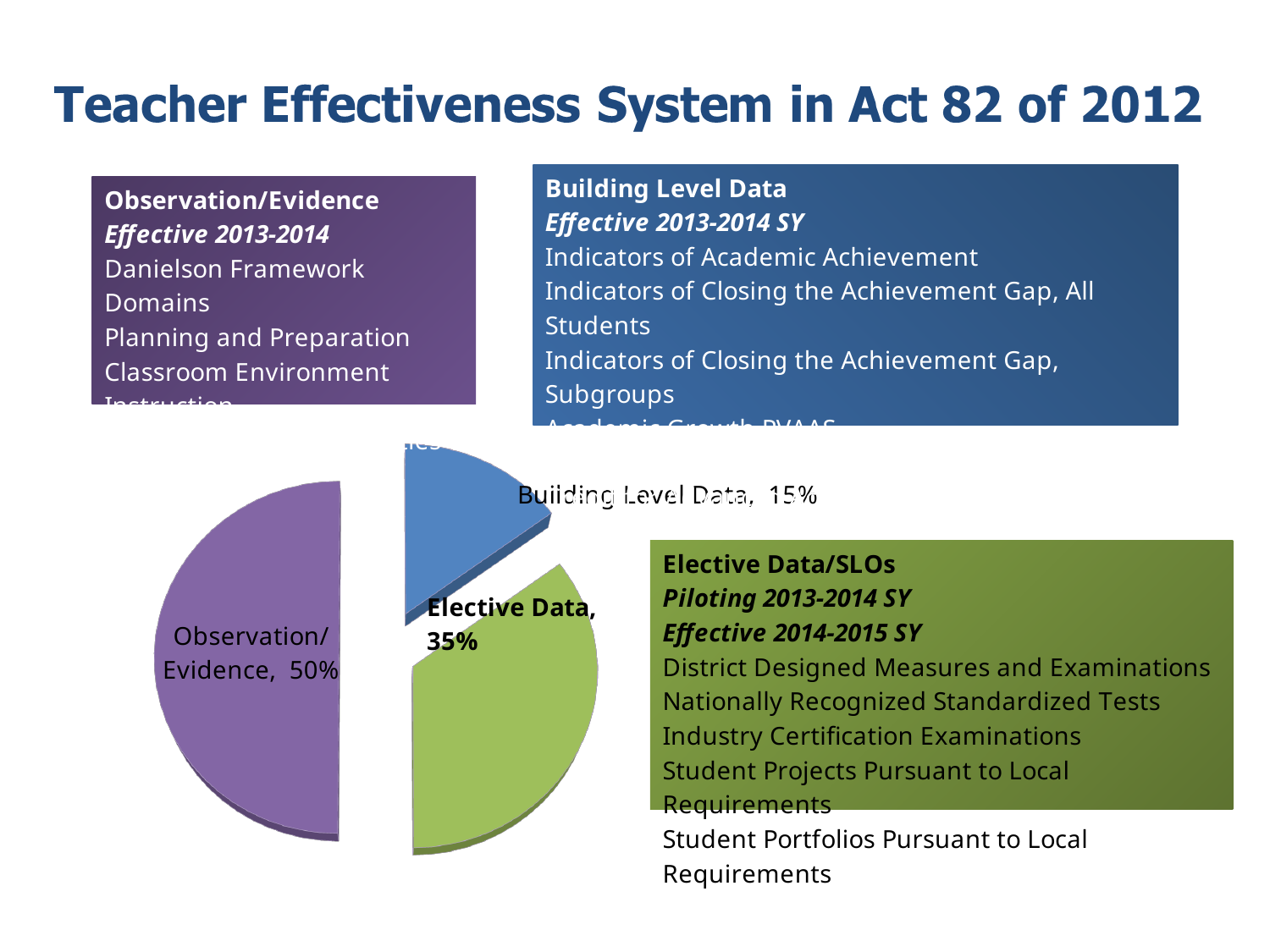
Which is larger, the Elective Data slice or the Building Level Data slice? Elective Data What kind of chart is shown on the slide? pie chart What colour is the Observation/Evidence slice of the pie? purple What is the combined share of Elective Data and Building Level Data? 50% Which slice of the pie is the smallest? Building Level Data What is the difference between the Elective Data share and the Building Level Data share? 20% What share of the pie does Observation/Evidence have? 50% What share of the pie does Elective Data have? 35% Which slice of the pie is the largest? Observation/Evidence How many slices does the pie chart have? 3 What is the difference between the Observation/Evidence share and the Elective Data share? 15% What share of the pie does Building Level Data have? 15%